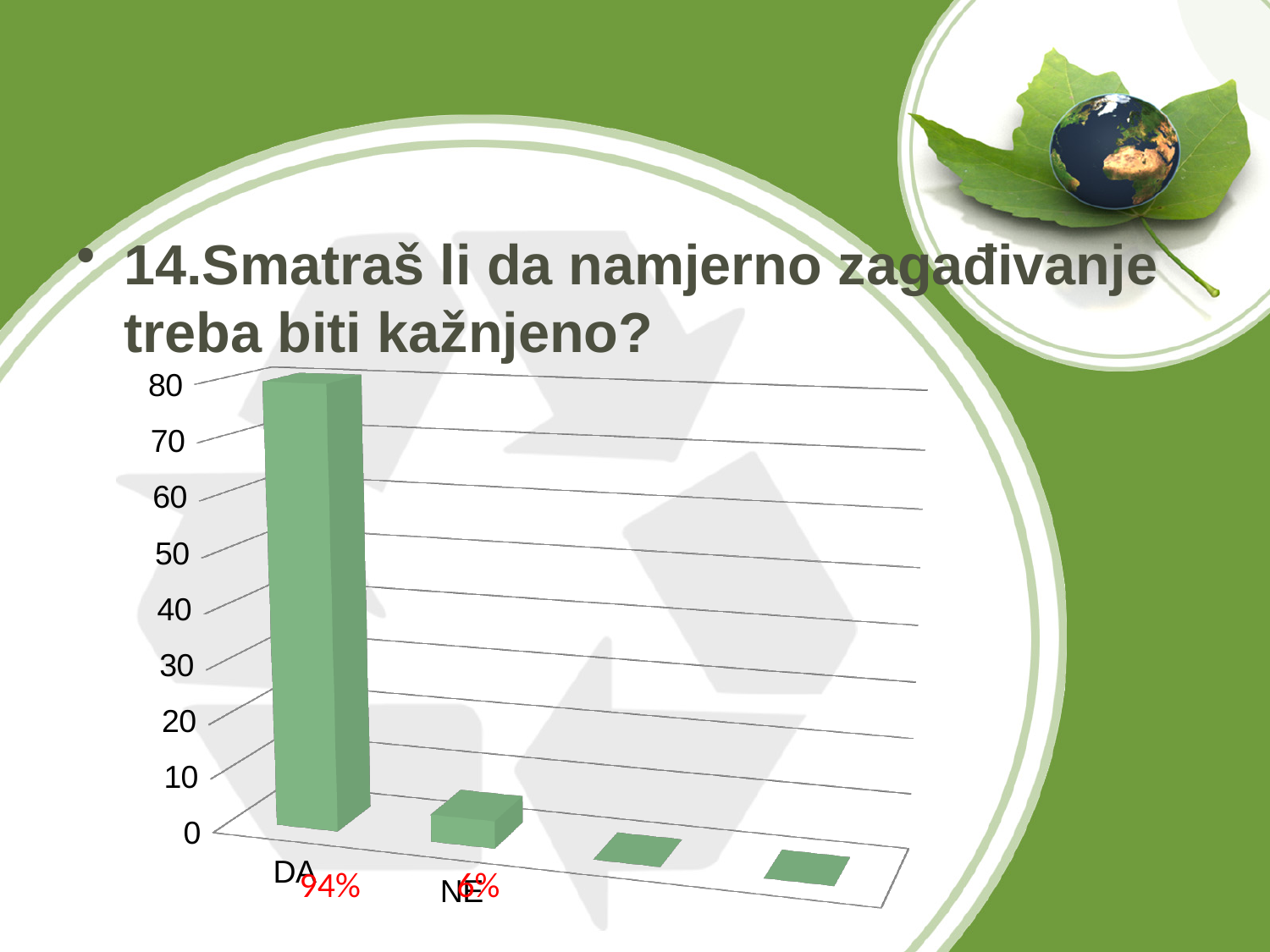
Which of the two labelled categories, DA or NE, has the lowest bar? NE What is the highest tick value shown on the vertical axis? 80 Is the value for NE greater or less than 20? less What kind of chart is shown on the slide? bar chart Is the value for DA greater or less than 70? greater Is the value for NE greater or less than 10? less Which category has the highest bar, DA or NE? DA What question is written as the title above the chart? 14.Smatraš li da namjerno zagađivanje treba biti kažnjeno? Do the bar values rise or fall going from DA to NE along the x axis? fall Is the bar for DA taller or shorter than the bar for NE? taller